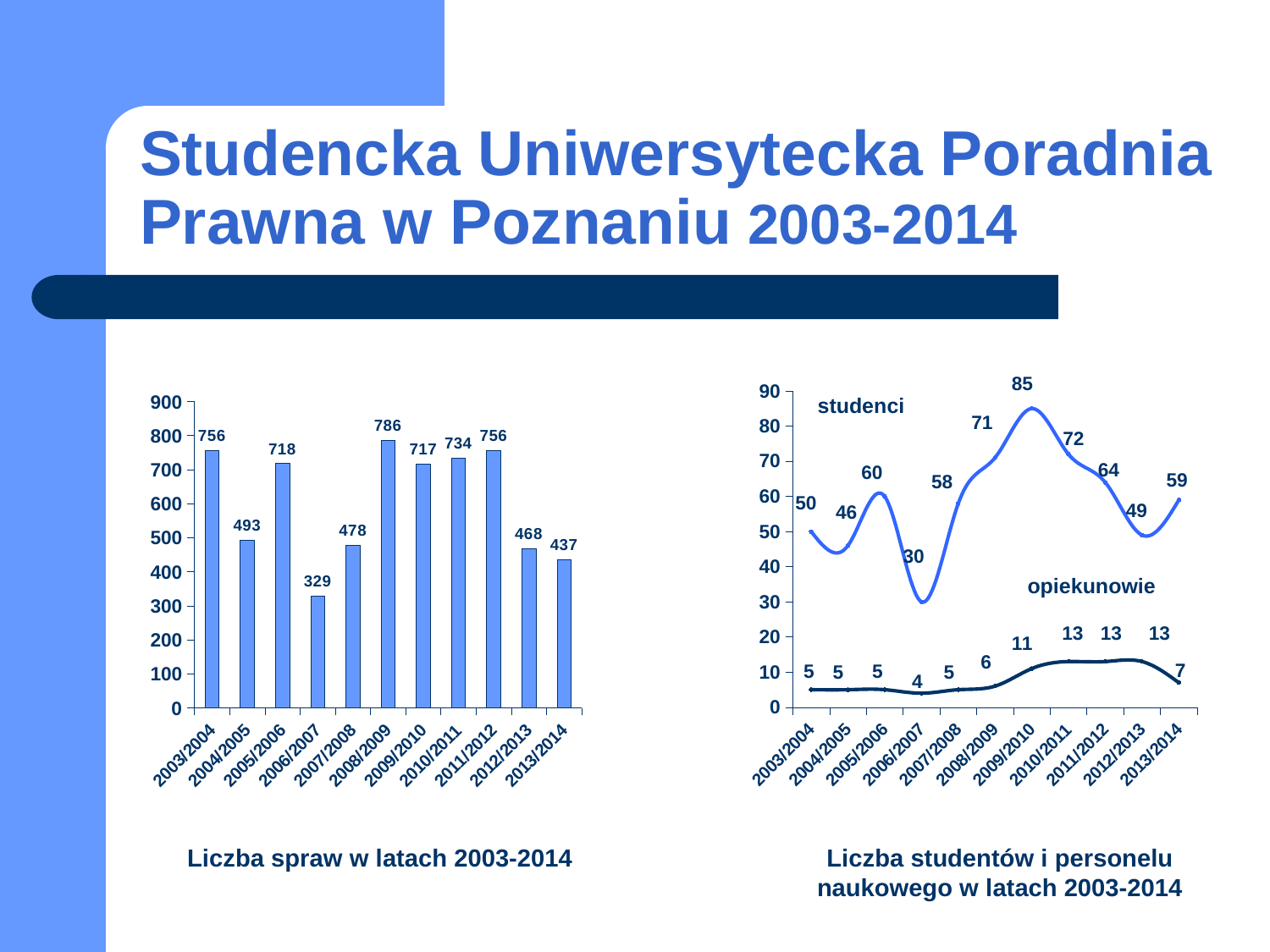
In the chart 'Liczba studentów i personelu naukowego w latach 2003-2014', what is the value for studenci in 2009/2010? 85 In the chart 'Liczba spraw w latach 2003-2014', what is the difference between the values for 2011/2012 and 2012/2013? 288 In the chart 'Liczba studentów i personelu naukowego w latach 2003-2014', in which year is the studenci value lowest? 2006/2007 In the chart 'Liczba spraw w latach 2003-2014', what is the value for 2006/2007? 329 In the chart 'Liczba spraw w latach 2003-2014', how many years are shown on the x axis? 11 What kind of chart is 'Liczba studentów i personelu naukowego w latach 2003-2014'? line chart In the chart 'Liczba studentów i personelu naukowego w latach 2003-2014', how many series are plotted? 2 In the chart 'Liczba spraw w latach 2003-2014', which year has the lowest value? 2006/2007 In the chart 'Liczba studentów i personelu naukowego w latach 2003-2014', which is larger: the studenci value in 2005/2006 or in 2007/2008? 2005/2006 In the chart 'Liczba studentów i personelu naukowego w latach 2003-2014', what is the value for opiekunowie in 2013/2014? 7 What kind of chart is 'Liczba spraw w latach 2003-2014'? bar chart In the chart 'Liczba spraw w latach 2003-2014', which year has the highest value? 2008/2009